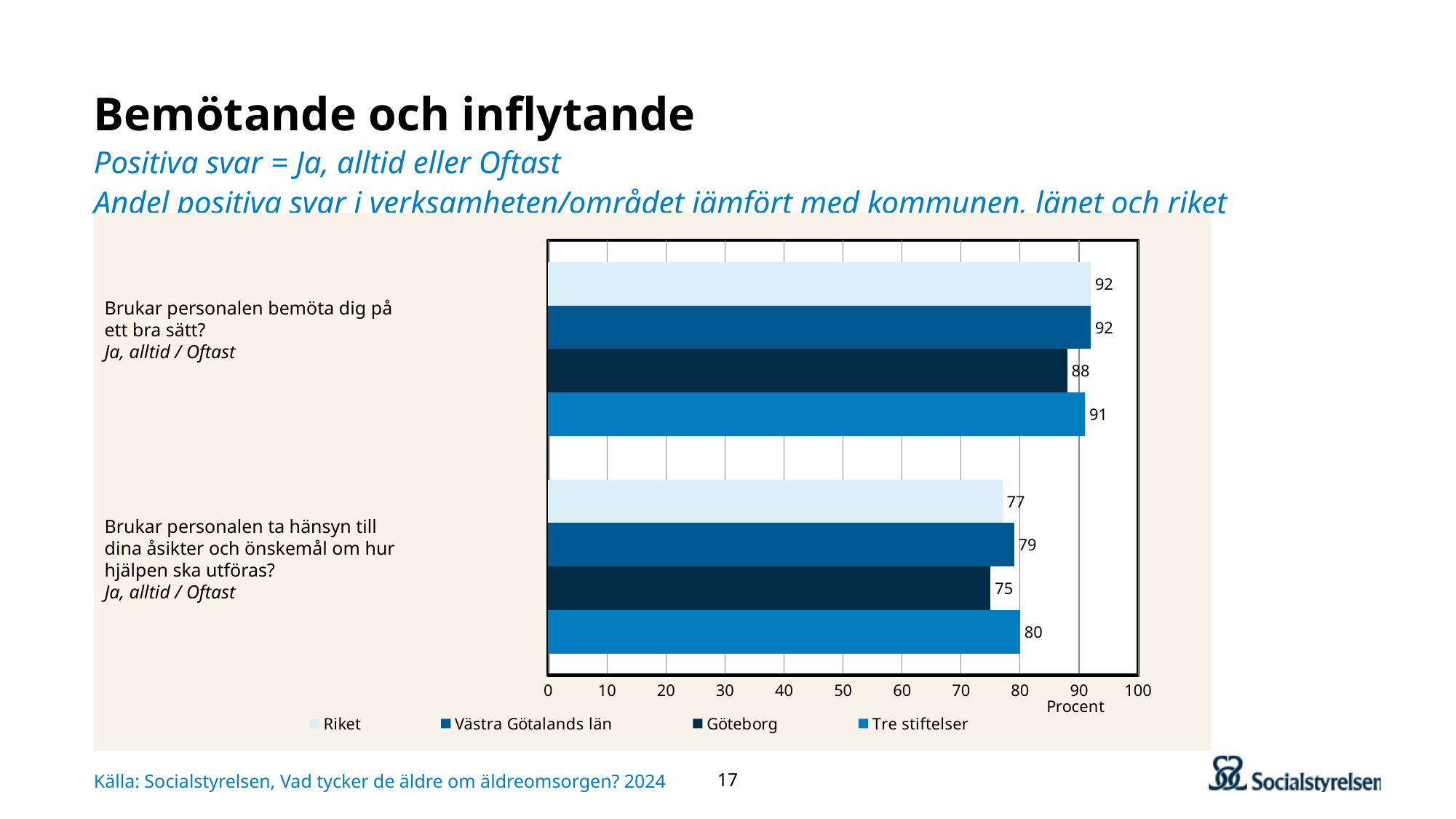
What is the value for Västra Götalands län on the question "Brukar personalen bemöta dig på ett bra sätt?"? 92 What is the value for Göteborg on the question "Brukar personalen bemöta dig på ett bra sätt?"? 88 What is the value for Tre stiftelser on the question "Brukar personalen ta hänsyn till dina åsikter och önskemål om hur hjälpen ska utföras?"? 80 Which series has the lowest value on the question "Brukar personalen ta hänsyn till dina åsikter och önskemål om hur hjälpen ska utföras?"? Göteborg Which is larger on the question "Brukar personalen ta hänsyn till dina åsikter och önskemål om hur hjälpen ska utföras?": Västra Götalands län or Riket? Västra Götalands län What kind of chart is shown on the slide? bar chart Which series has the highest value on the question "Brukar personalen ta hänsyn till dina åsikter och önskemål om hur hjälpen ska utföras?"? Tre stiftelser What is the value for Riket on the question "Brukar personalen ta hänsyn till dina åsikter och önskemål om hur hjälpen ska utföras?"? 77 How many series does the legend list? 4 What unit is shown on the horizontal axis of the chart? Procent Is the value for Göteborg on the question "Brukar personalen ta hänsyn till dina åsikter och önskemål om hur hjälpen ska utföras?" greater or less than 80? less What is the difference between the Tre stiftelser value and the Göteborg value on the question "Brukar personalen bemöta dig på ett bra sätt?"? 3